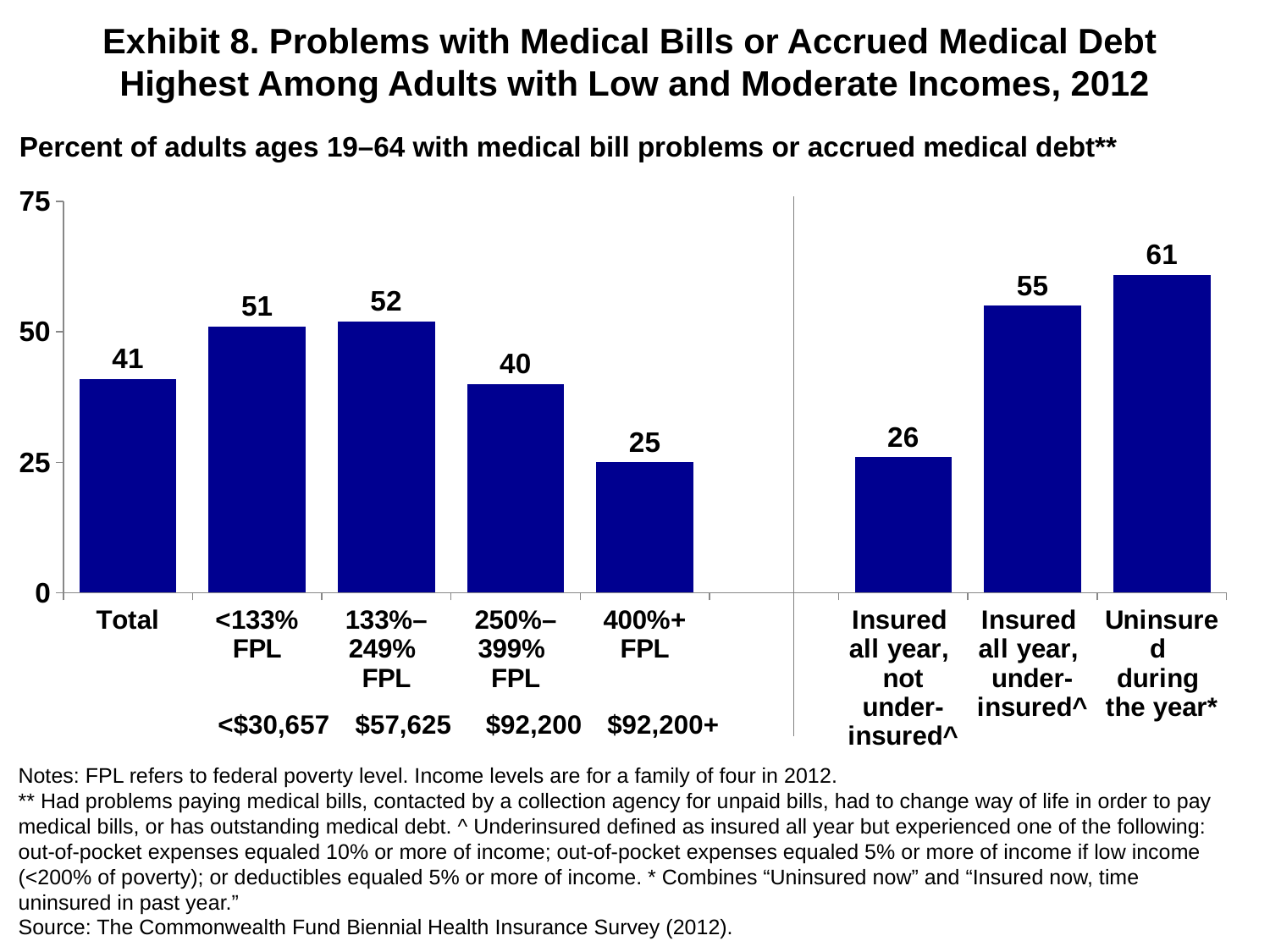
What is the highest value shown on the vertical axis? 75 What kind of chart is this? Bar chart What is the difference between the values for 133%–249% FPL and 400%+ FPL? 27 What is the difference between the values for uninsured during the year and insured all year, not underinsured? 35 Which category has the highest value? Uninsured during the year What is the value for Total? 41 What is the value for adults with incomes of 400%+ FPL? 25 How many bars are shown on the chart? 8 Which category has the lowest value? 400%+ FPL What is the value for adults uninsured during the year? 61 What is the value for adults insured all year but underinsured? 55 Which is larger, the value for <133% FPL or the value for 250%–399% FPL? <133% FPL